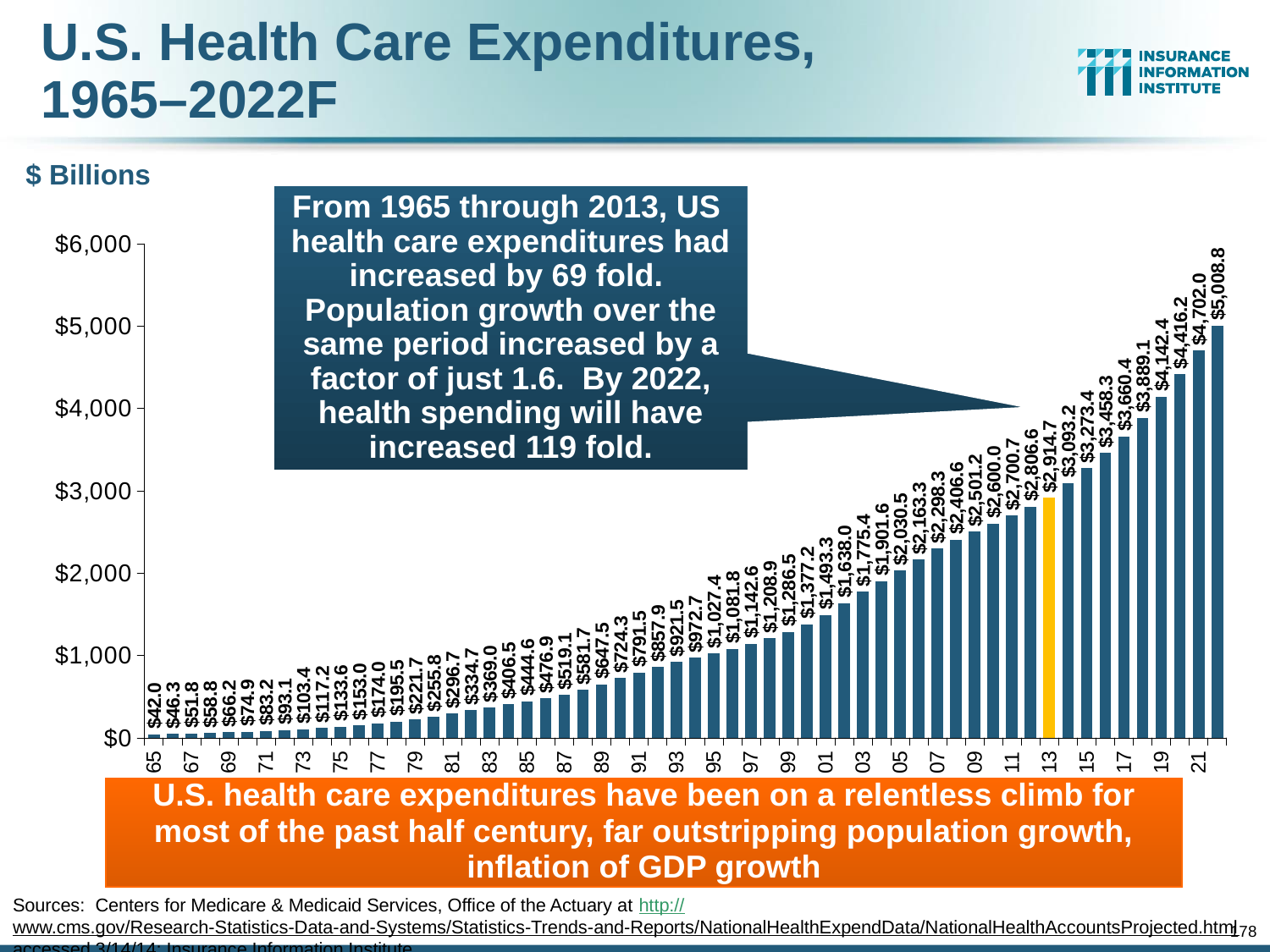
Which year has the highest health care expenditure on the chart? 2022 (22) Which is larger, the value for 2005 (05) or the value for 1995 (95)? 2005 (05) Which year has the lowest health care expenditure on the chart? 1965 (65) What is the value for 2013 (labelled 13) on the chart? $2,914.7 What is the value for 1965 (labelled 65) on the chart? $42.0 Do the values rise or fall from 1965 to 2022 along the x axis? Rise What is the value for 2022 (labelled 22), the last bar on the chart? $5,008.8 What is the difference between the 2022 value and the 2013 value? $2,094.1 Which year's bar is highlighted in yellow/orange instead of blue? 2013 (13) What kind of chart is shown on the slide? Bar chart What is the value for 2000 (labelled 01 is 2001; the bar labelled 01 minus one, i.e. 2000)? $1,377.2 Is the value for 2011 (labelled 11) greater or less than $2,000? greater